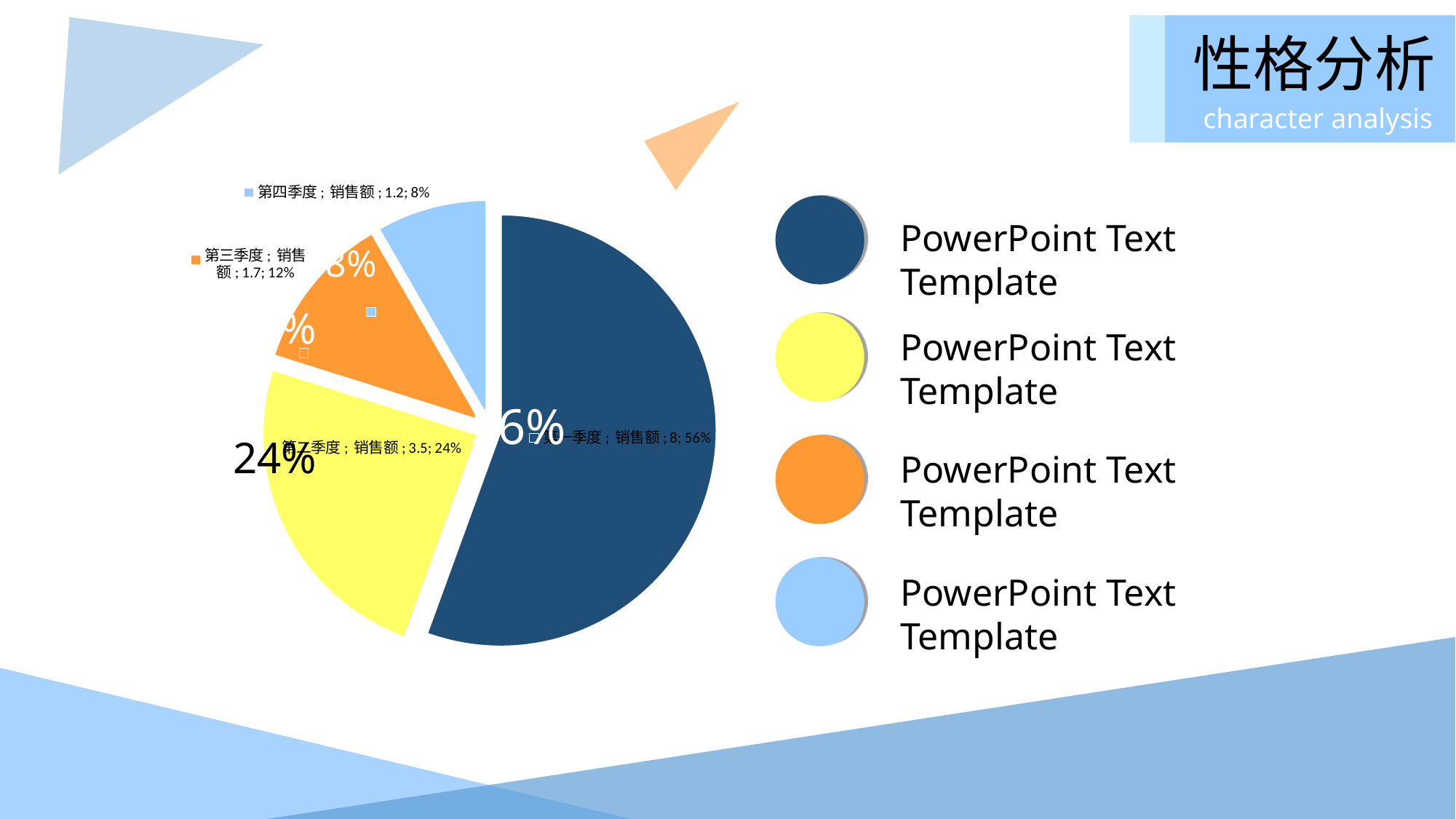
Which has a larger 销售额 value, 第三季度 or 第四季度? 第三季度 How many slices does the pie chart have? 4 What kind of chart is shown on the slide? pie chart Which quarter has the smallest slice in the pie chart? 第四季度 Which quarter has the largest slice in the pie chart? 第一季度 What is the 销售额 value for 第四季度? 1.2 What is the difference between the 销售额 values of 第一季度 and 第二季度? 4.5 What is the 销售额 value for 第一季度? 8 What percentage share does 第二季度 have in the pie chart? 24% What colour is the slice for 第一季度? dark blue What percentage share does 第四季度 have in the pie chart? 8% What is the 销售额 value for 第三季度? 1.7